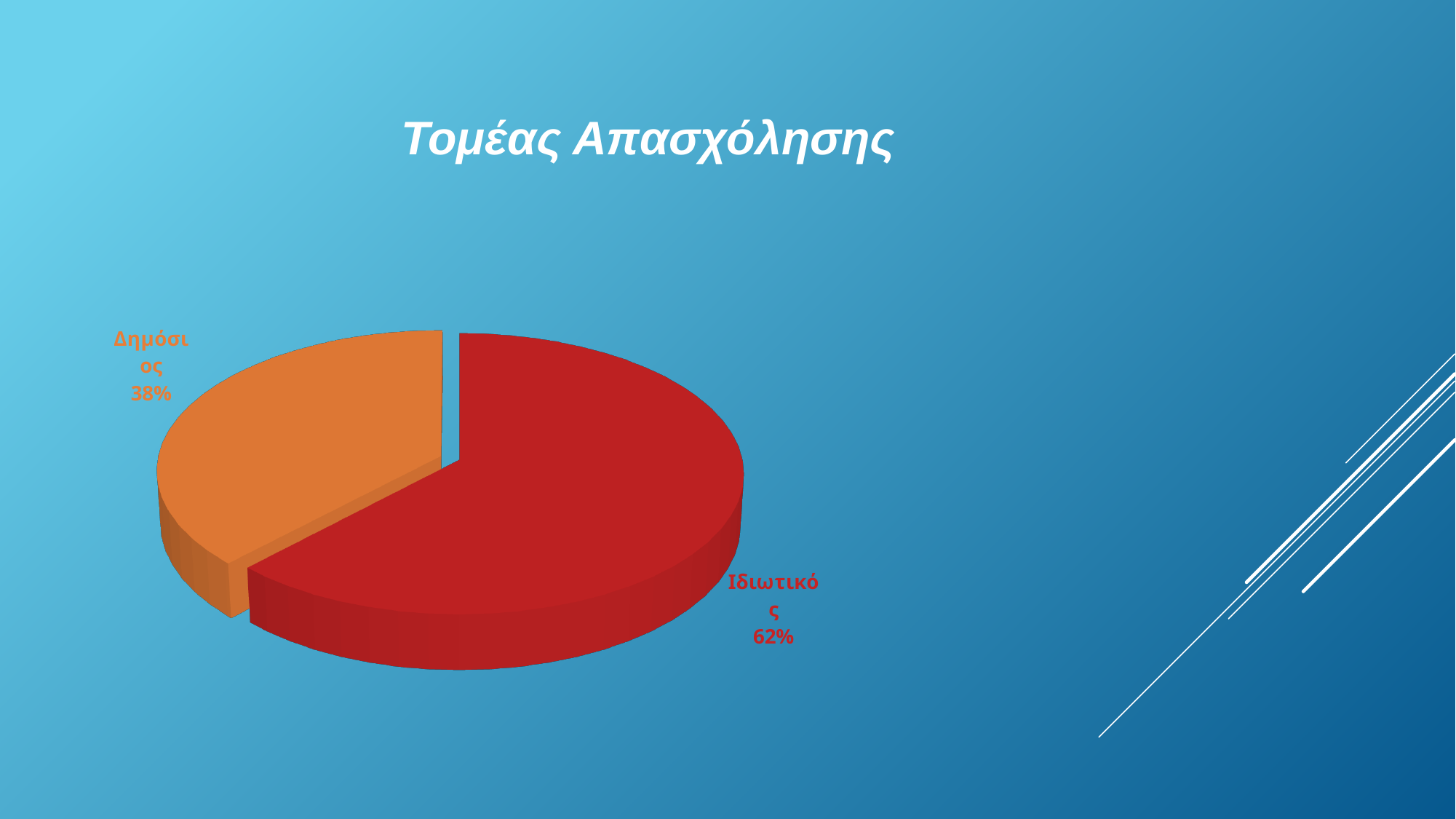
Which sector has the smallest share of the pie? Δημόσιος What colour is the Ιδιωτικός slice? Red Which sector has the largest share of the pie? Ιδιωτικός What share of the pie does Ιδιωτικός represent? 62% How many slices does the pie chart have? 2 What share of the pie does Δημόσιος represent? 38% What is the title of the chart? Τομέας Απασχόλησης What kind of chart is shown on the slide? Pie chart Which is larger, the share for Δημόσιος or the share for Ιδιωτικός? Ιδιωτικός What is the difference in percentage points between Ιδιωτικός and Δημόσιος? 24